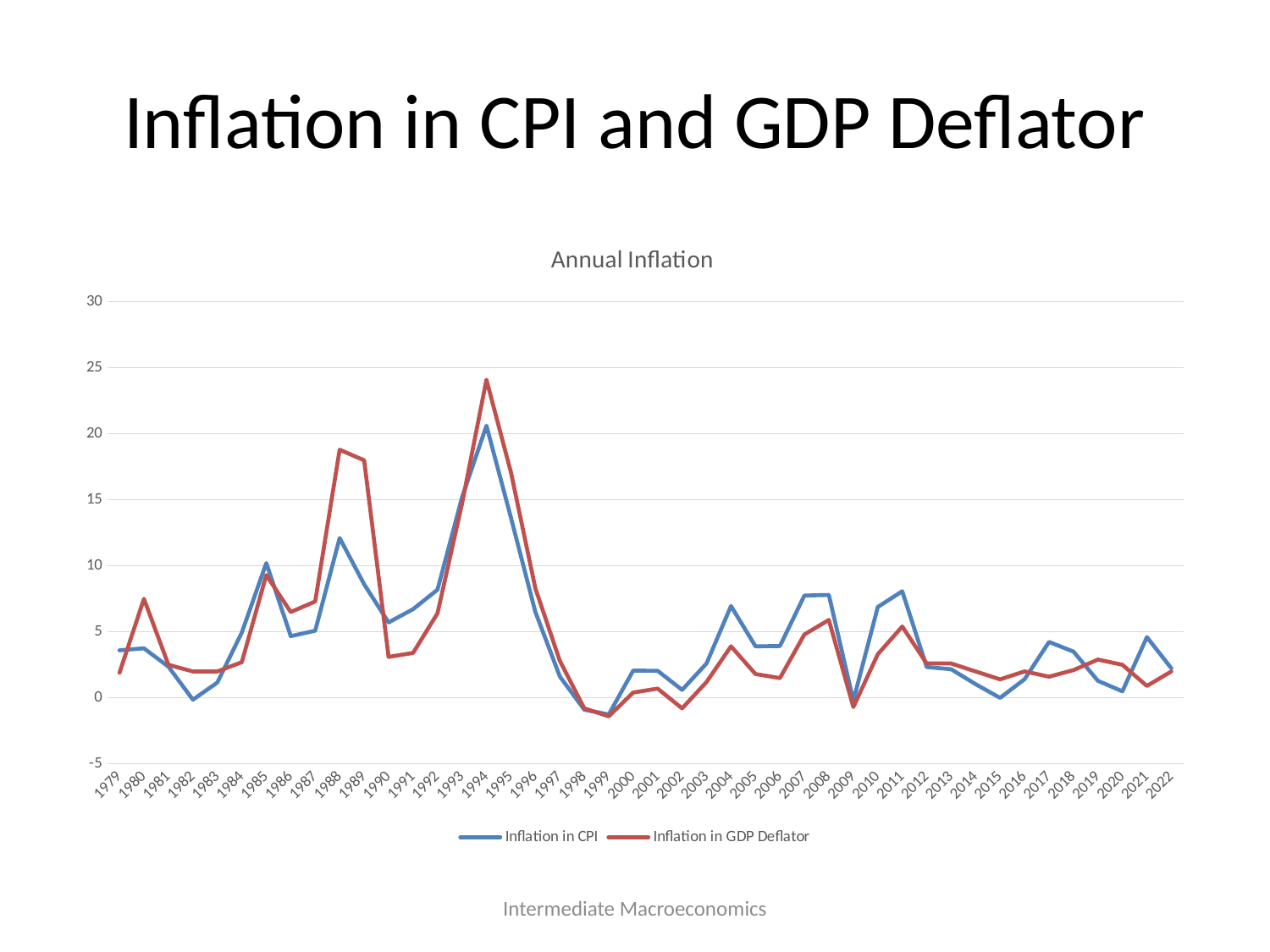
Is the value of Inflation in GDP Deflator in 1988 greater or less than 15? greater In 1988, which series has the higher value, Inflation in CPI or Inflation in GDP Deflator? Inflation in GDP Deflator In 2011, which series has the higher value, Inflation in CPI or Inflation in GDP Deflator? Inflation in CPI In which year does Inflation in GDP Deflator reach its highest value? 1994 Is the value of Inflation in GDP Deflator in 1994 greater or less than 20? greater In which year does Inflation in CPI reach its highest value? 1994 How many series does the legend list? 2 What is the title shown above the chart's plot area? Annual Inflation What kind of chart is shown on the slide? line chart Is the value of Inflation in CPI in 1982 greater or less than 5? less Does Inflation in CPI rise or fall from 1994 to 1998? fall How many years are plotted along the x axis? 44